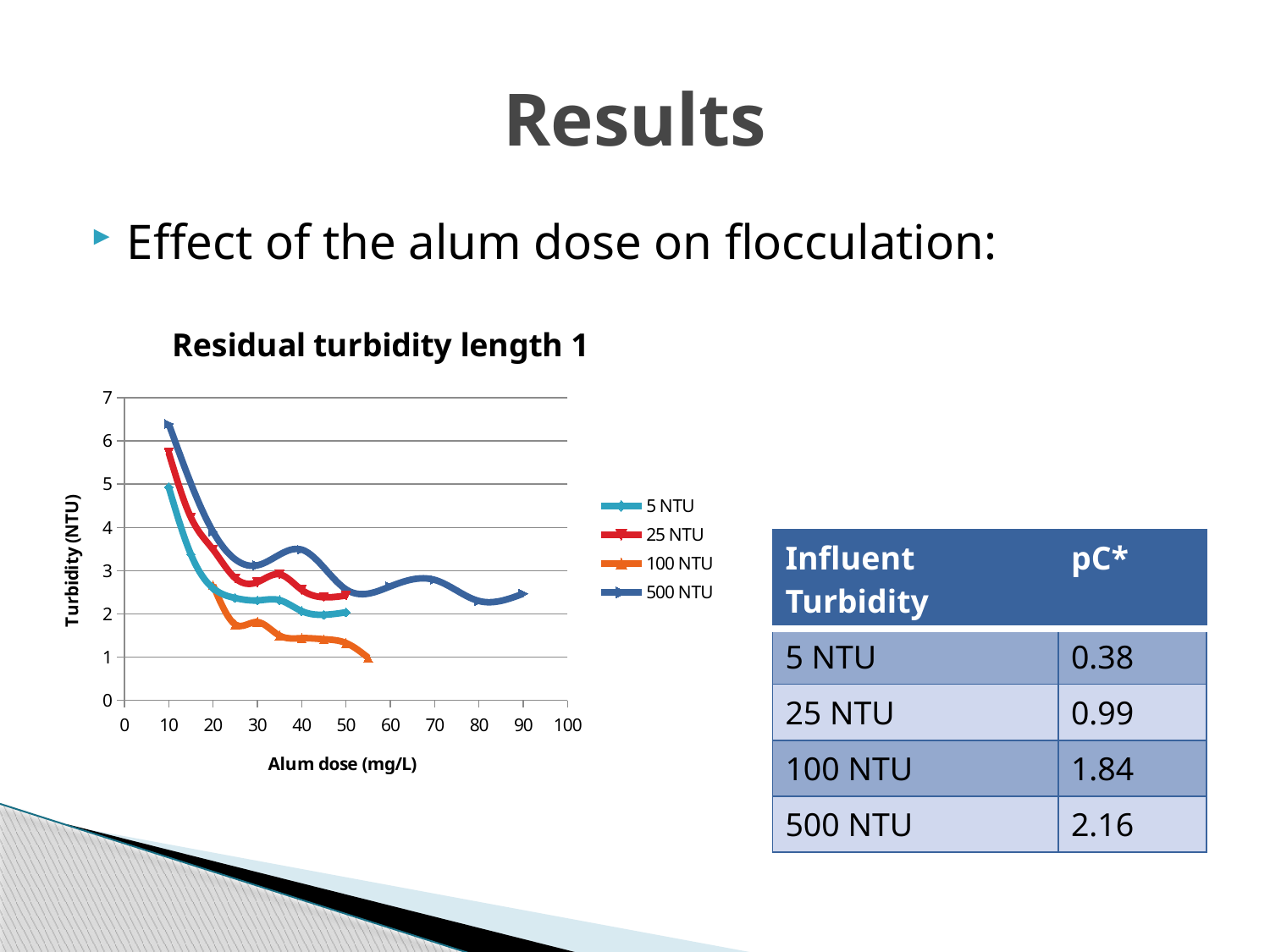
Is the turbidity for the 100 NTU series at an alum dose of 40 mg/L greater or less than 2? less What is the label of the x axis of the chart? Alum dose (mg/L) Which series has the lowest turbidity at an alum dose of 30 mg/L? 100 NTU Is the turbidity for the 500 NTU series at an alum dose of 10 mg/L greater or less than 6? greater What is the title of the chart? Residual turbidity length 1 At an alum dose of 30 mg/L, which series has the higher turbidity, 25 NTU or 100 NTU? 25 NTU How many series does the legend of the chart list? 4 At an alum dose of 10 mg/L, which series has the higher turbidity, 500 NTU or 5 NTU? 500 NTU Does the turbidity for the 5 NTU series rise or fall as the alum dose increases from 10 to 20 mg/L? fall What kind of chart is shown on the slide? line chart Is the turbidity for the 25 NTU series at an alum dose of 10 mg/L greater or less than 5? greater